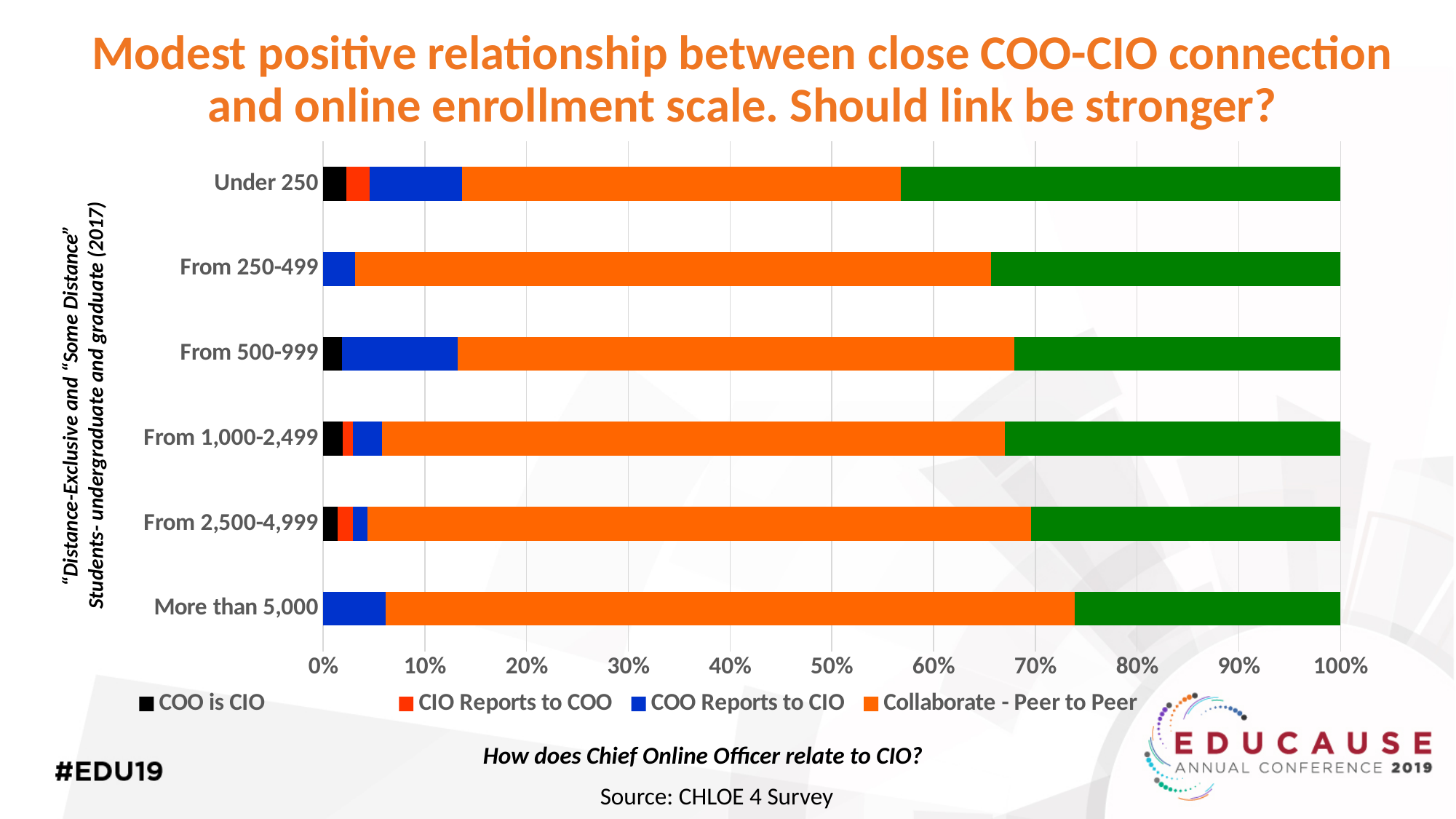
What is the source cited below the chart? CHLOE 4 Survey How many enrollment-size categories are plotted on the y axis? 6 Is the 'COO Reports to CIO' value for 'More than 5,000' greater or less than 10%? less Which has the larger 'Collaborate - Peer to Peer' share: 'Under 250' or 'More than 5,000'? More than 5,000 Does the combined share of the non-green segments rise or fall as enrollment size increases from 'Under 250' to 'More than 5,000'? Rises Which colour represents 'Collaborate - Peer to Peer' in the legend? Orange How many series does the legend list? 4 What kind of chart is shown on the slide? Stacked bar chart Which enrollment category has the largest green segment? Under 250 Is the 'Collaborate - Peer to Peer' value for 'More than 5,000' greater or less than 60%? greater Is the 'Collaborate - Peer to Peer' value for 'Under 250' greater or less than 50%? less